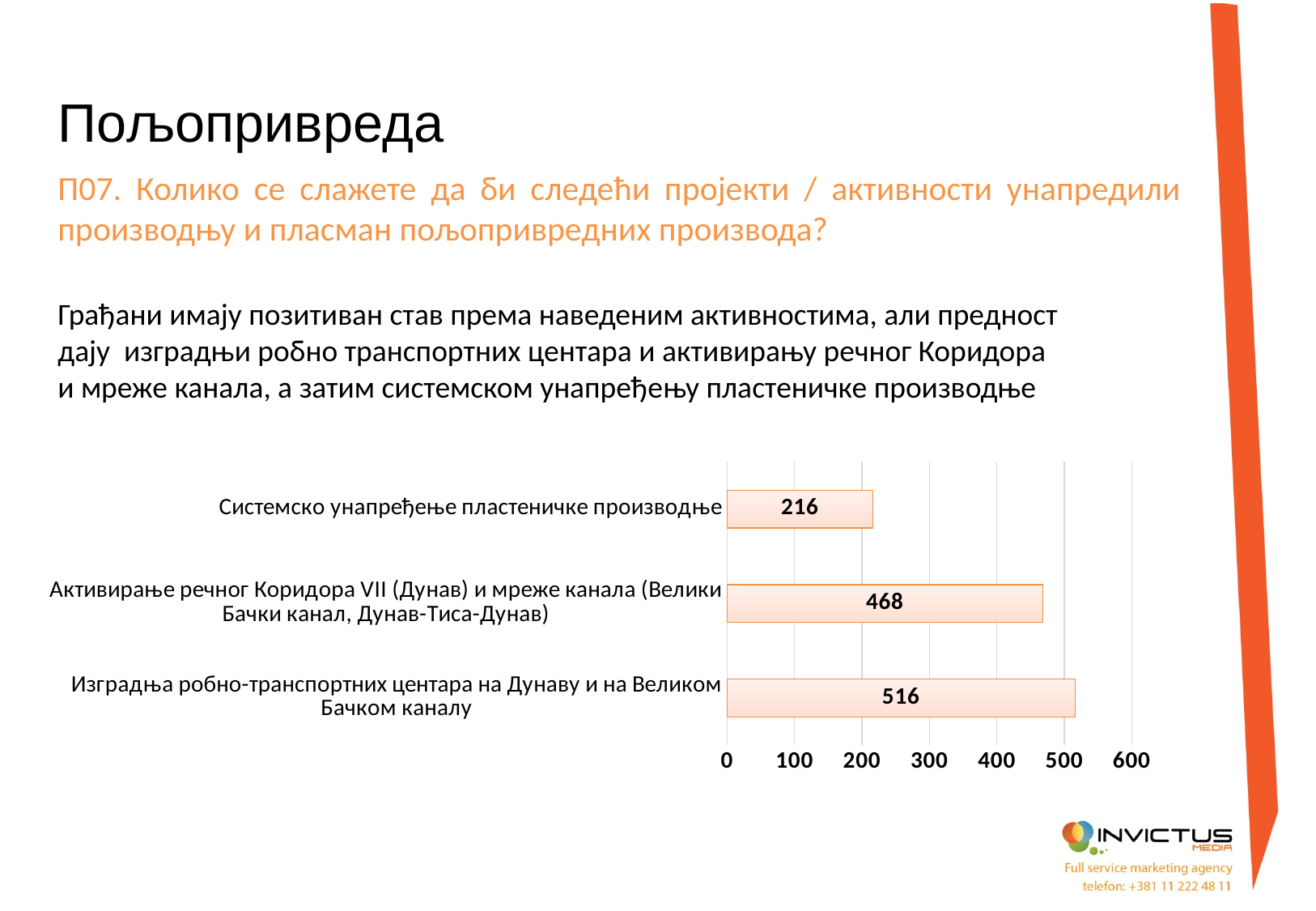
What is the value for Изградња робно-транспортних центара на Дунаву и на Великом Бачком каналу? 516 Which category has the highest value? Изградња робно-транспортних центара на Дунаву и на Великом Бачком каналу Is the value for Изградња робно-транспортних центара greater or less than 500? greater What is the difference between the values for Изградња робно-транспортних центара and Активирање речног Коридора VII? 48 What kind of chart is shown on the slide? bar chart What is the value for Активирање речног Коридора VII (Дунав) и мреже канала (Велики Бачки канал, Дунав-Тиса-Дунав)? 468 What is the maximum value shown on the horizontal axis? 600 What is the value for Системско унапређење пластеничке производње? 216 What is the difference between the values for Активирање речног Коридора VII and Системско унапређење пластеничке производње? 252 Which is larger: the value for Активирање речног Коридора VII or the value for Системско унапређење пластеничке производње? Активирање речног Коридора VII How many categories are shown in the chart? 3 Which category has the lowest value? Системско унапређење пластеничке производње